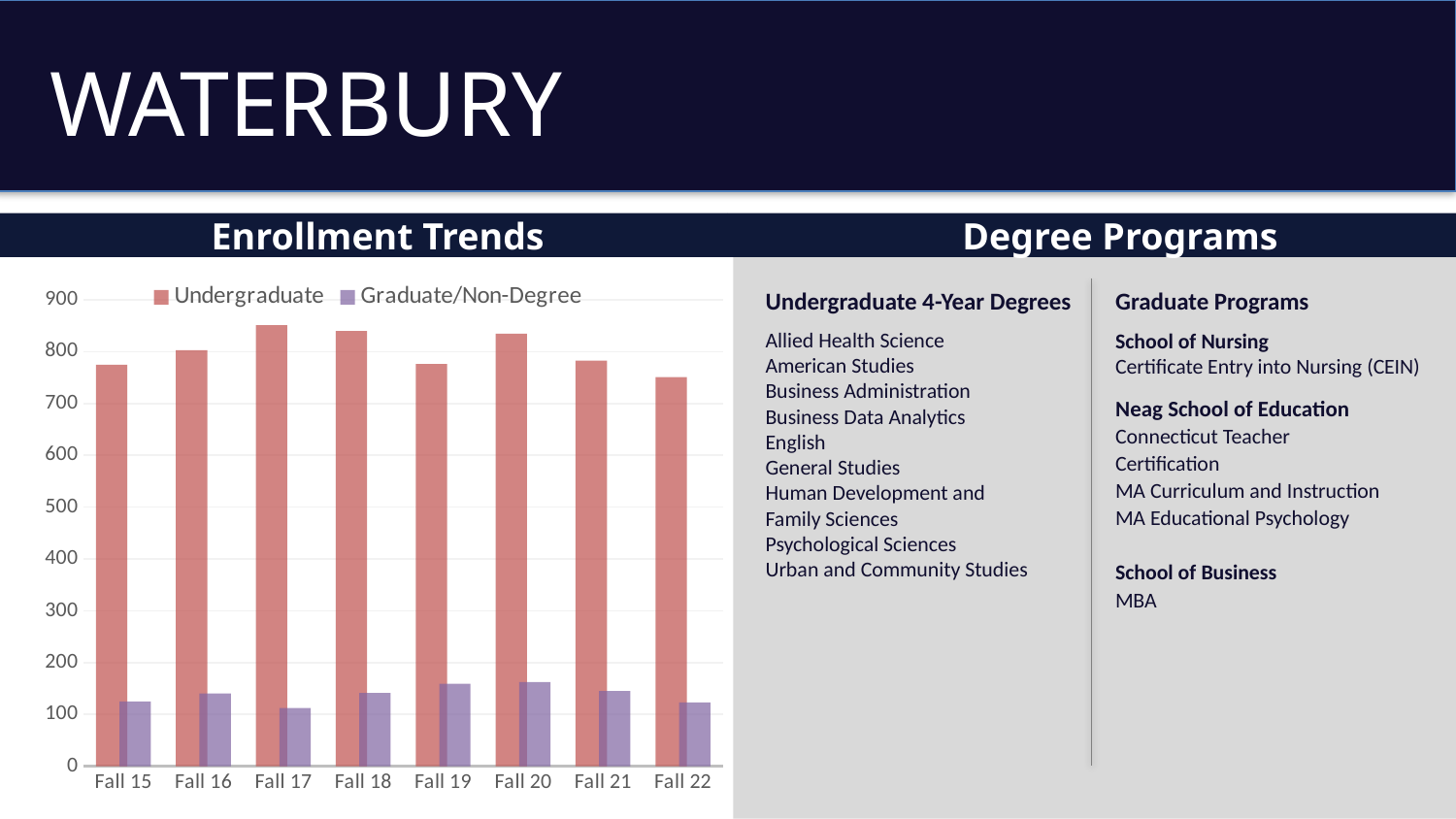
Is the Graduate/Non-Degree value for Fall 17 greater or less than 200? less Which is larger: the Undergraduate value for Fall 17 or for Fall 22? Fall 17 Is the Undergraduate value for Fall 17 greater or less than 800? greater How many fall terms are shown on the x axis of the Enrollment Trends chart? 8 Is the Graduate/Non-Degree value for Fall 19 greater or less than 100? greater Which series in the Enrollment Trends chart is shown in purple? Graduate/Non-Degree Which fall term has the lowest Graduate/Non-Degree enrollment in the Enrollment Trends chart? Fall 17 What kind of chart is shown under the Enrollment Trends heading? Bar chart Which fall term has the lowest Undergraduate enrollment in the Enrollment Trends chart? Fall 22 Do Undergraduate values rise or fall from Fall 20 to Fall 22? fall How many series does the legend of the Enrollment Trends chart list? 2